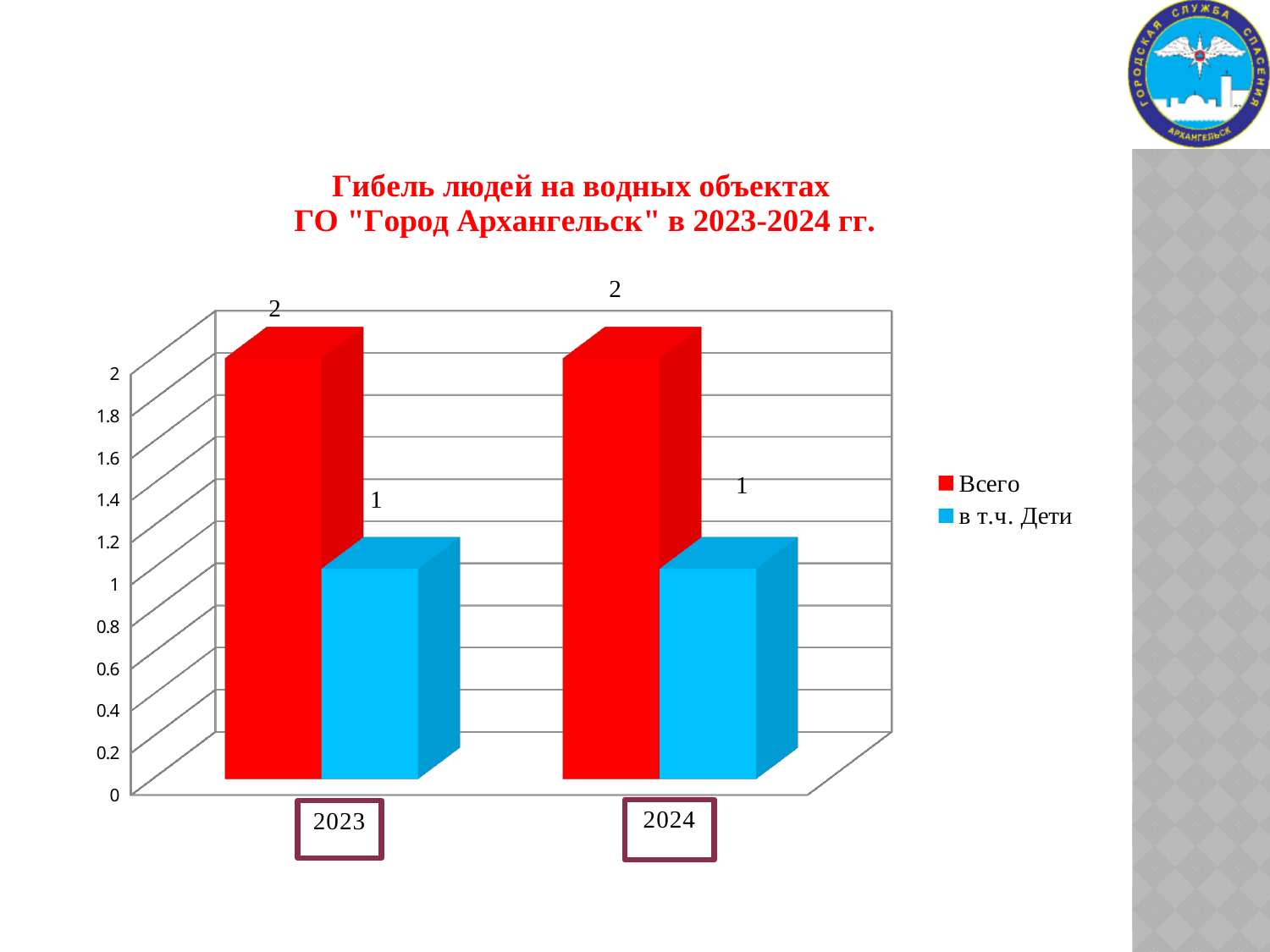
What is the value for "в т.ч. Дети" in 2024? 1 What is the value for "в т.ч. Дети" in 2023? 1 Which colour represents the "в т.ч. Дети" series? blue Which is larger in 2024, "Всего" or "в т.ч. Дети"? Всего What is the value for "Всего" in 2024? 2 How many series does the legend list? 2 What is the value for "Всего" in 2023? 2 How many categories are shown on the x axis? 2 What is the title of the chart? Гибель людей на водных объектах ГО "Город Архангельск" в 2023-2024 гг. What is the difference between "Всего" and "в т.ч. Дети" in 2023? 1 Does the value for "Всего" rise, fall or stay the same from 2023 to 2024? stays the same What kind of chart is shown on the slide? bar chart